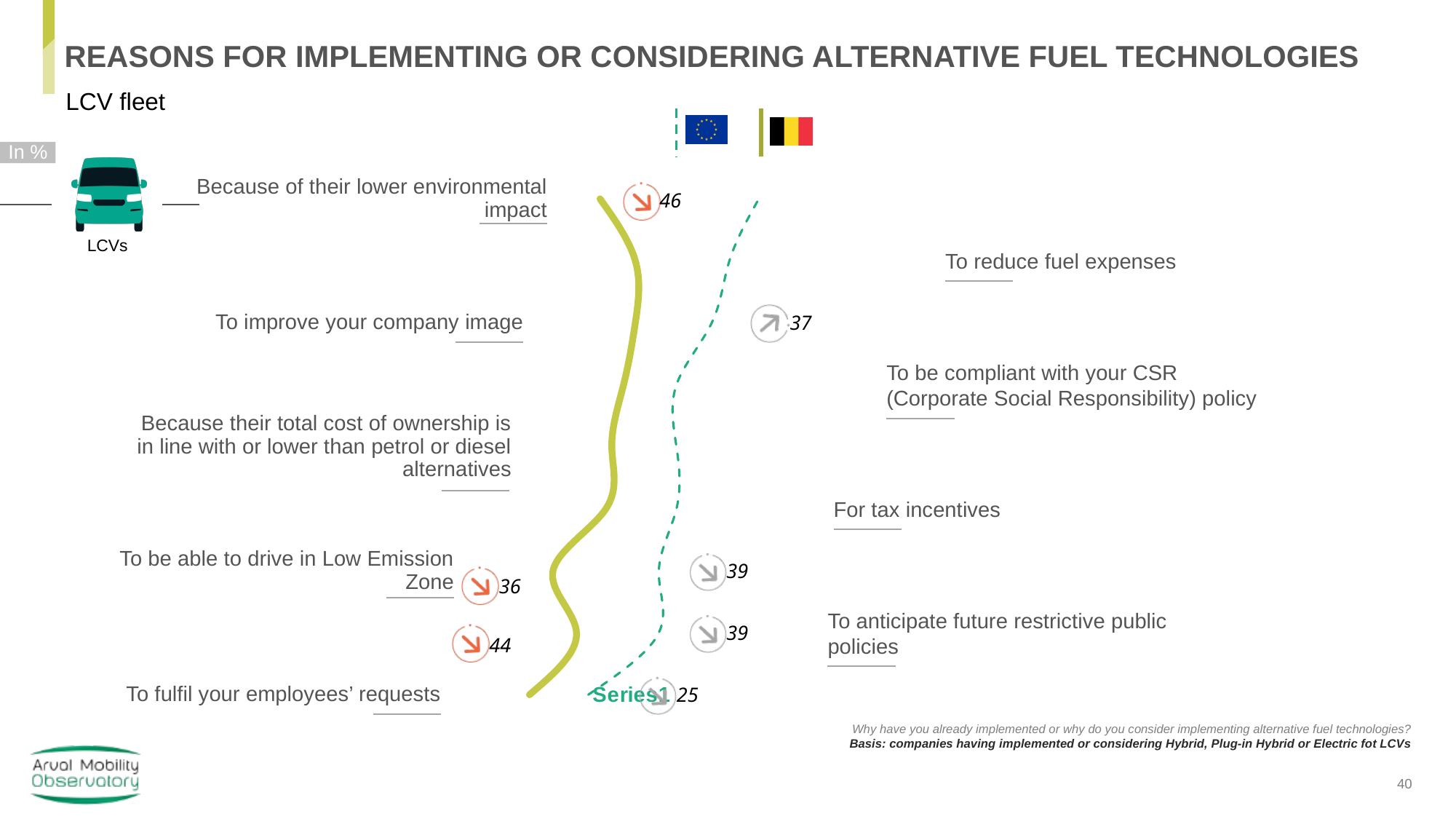
What value is printed next to 'To be able to drive in Low Emission Zone'? 36 What value is printed next to 'Because of their lower environmental impact'? 46 What is the highest value printed on the chart? 46 What kind of chart is shown on the slide? line chart What is the title of the slide containing the chart? Reasons for implementing or considering alternative fuel technologies What is the lowest value printed on the chart? 25 How many reasons (categories) are listed on the chart? 9 In what unit are the chart values expressed, according to the label at the top left? % Which is larger: the value printed for 'Because of their lower environmental impact' or the value printed for 'To fulfil your employees' requests'? Because of their lower environmental impact How many lines (series) are plotted on the chart? 2 What value is printed next to 'To fulfil your employees' requests'? 25 What is the difference between the highest printed value (46) and the lowest printed value (25)? 21